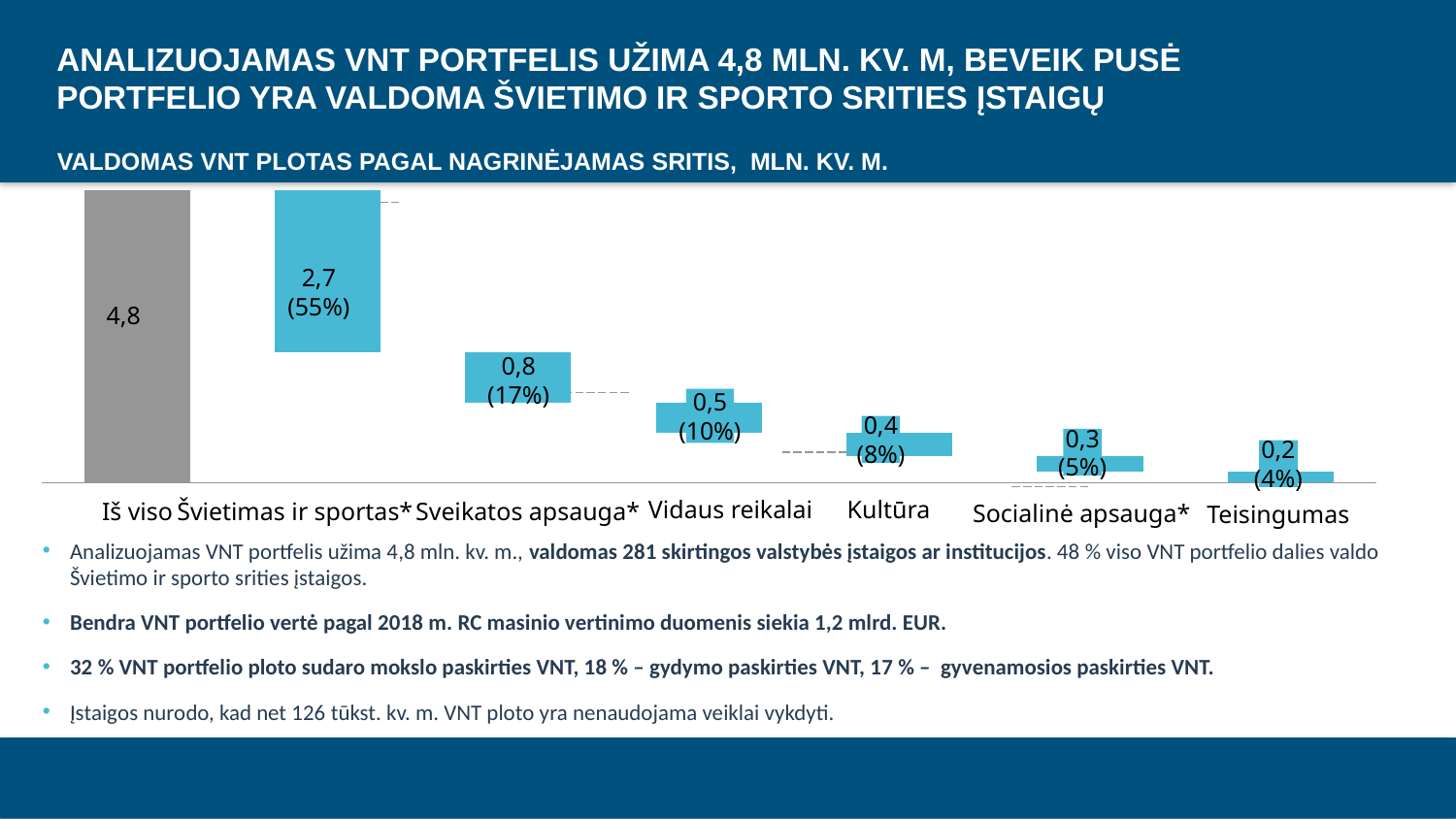
What percentage share is shown for Teisingumas? 4% Which category has the lowest value? Teisingumas Which is larger, the value for Kultūra or the value for Socialinė apsauga*? Kultūra How many categories are shown on the x axis, including Iš viso? 7 What is the value shown for Vidaus reikalai? 0,5 What is the value shown for Iš viso? 4,8 What is the difference between the values for Švietimas ir sportas* and Sveikatos apsauga*? 1,9 What kind of chart is shown on the slide? Bar chart Excluding the Iš viso total, which category has the highest value? Švietimas ir sportas* What is the title of the chart? VALDOMAS VNT PLOTAS PAGAL NAGRINĖJAMAS SRITIS, MLN. KV. M. What percentage share is shown for Sveikatos apsauga*? 17% What is the value shown for Švietimas ir sportas*? 2,7